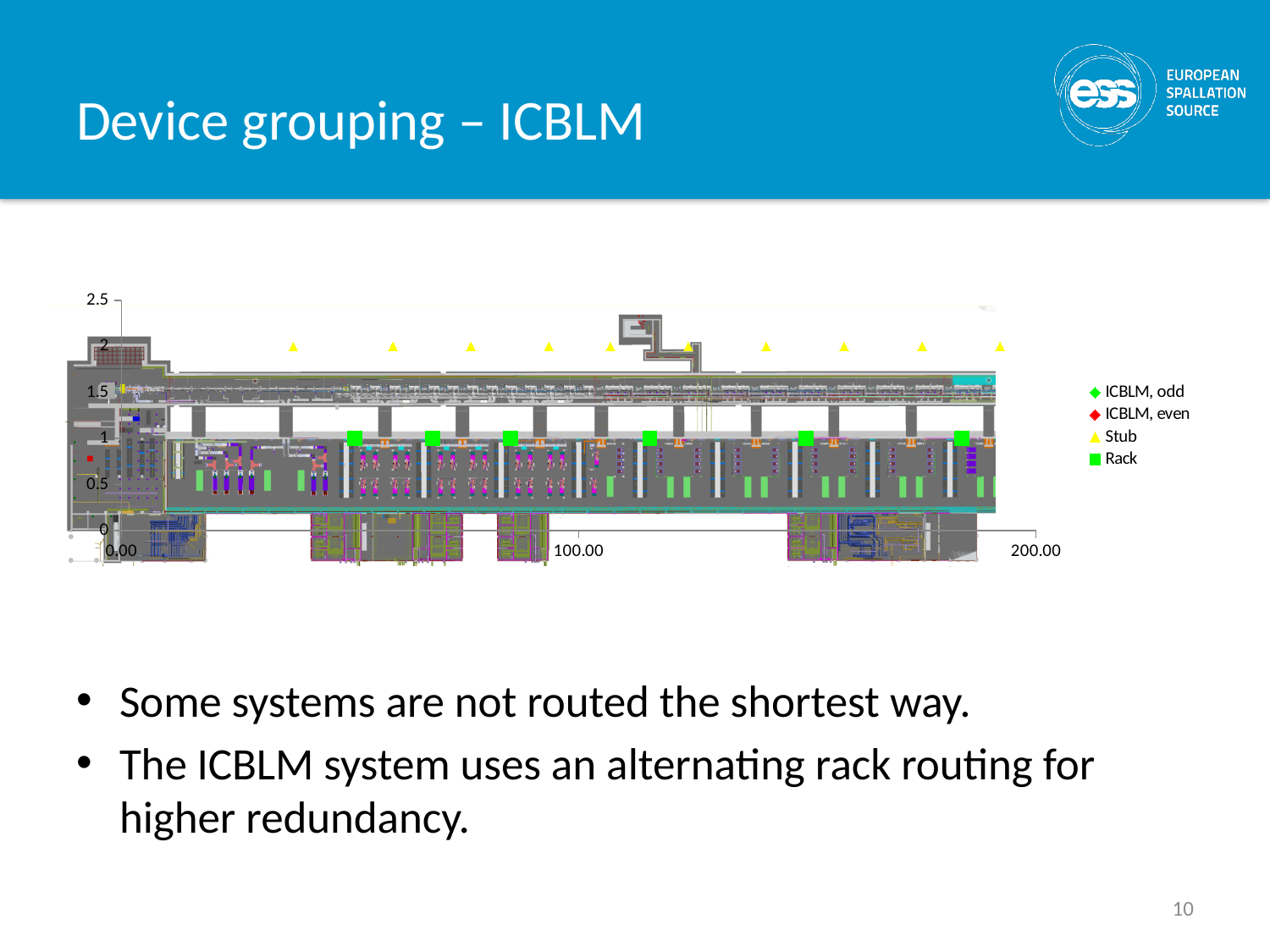
Which series is shown with green square markers? Rack What kind of chart is shown on the slide? scatter chart Are the Rack markers plotted at a vertical value greater or less than 1.5? less What is the highest value shown on the vertical axis? 2.5 How many series does the legend list? 4 Which series is plotted higher on the vertical axis, Stub or Rack? Stub What is the largest value labelled on the horizontal axis? 200.00 How many Rack markers are plotted on the chart? 6 Are the Stub markers plotted at a vertical value greater or less than 1.5? greater How many Stub markers are plotted on the chart? 10